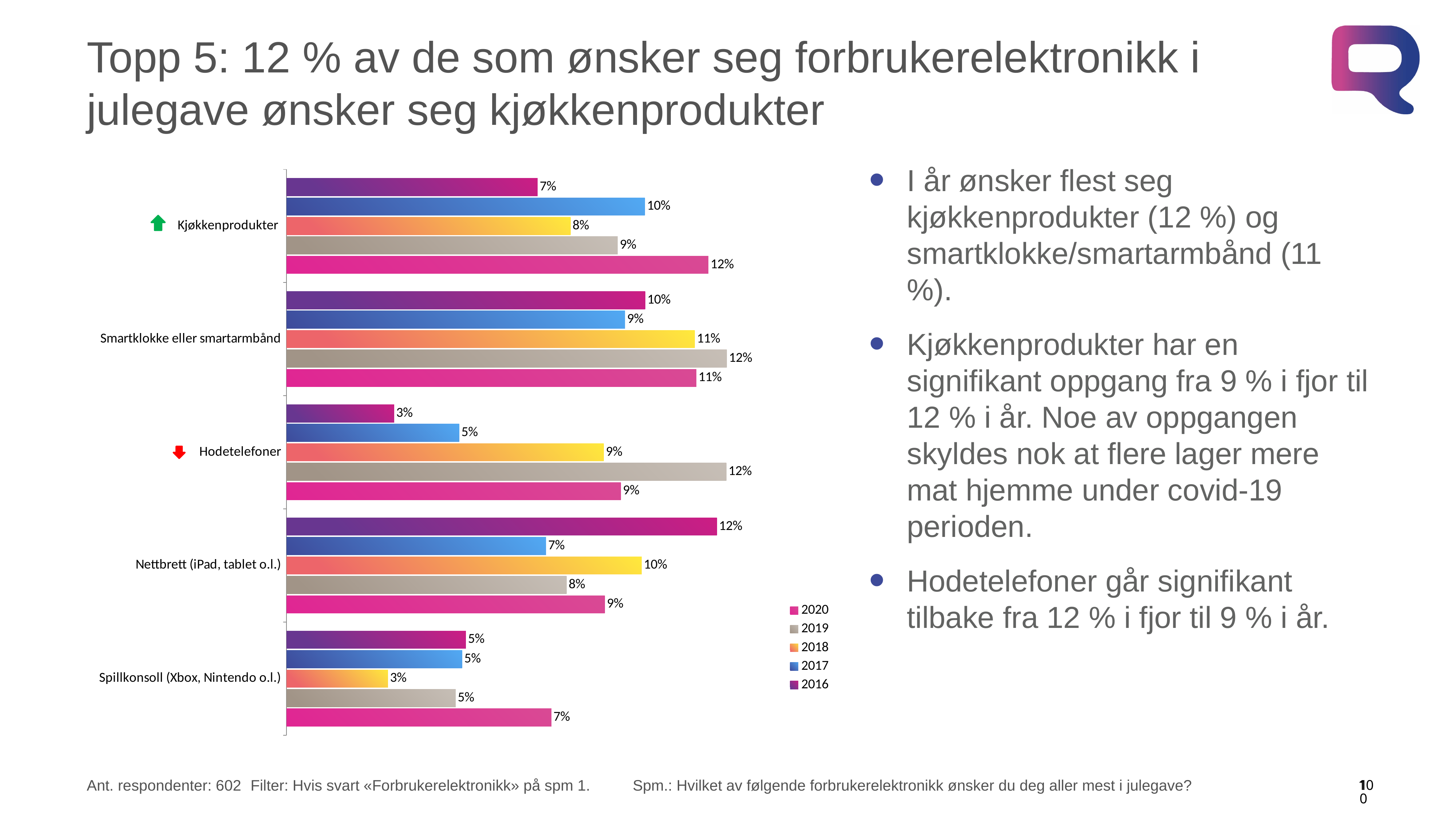
How many series does the legend list? 5 What is the 2018 value for Spillkonsoll (Xbox, Nintendo o.l.)? 3% What is the 2016 value for Nettbrett (iPad, tablet o.l.)? 12% Which category has the highest 2020 value? Kjøkkenprodukter Which series is shown in the legend with the grey colour? 2019 Which category has the lowest 2020 value? Spillkonsoll (Xbox, Nintendo o.l.) What kind of chart is shown on the slide? bar chart How many product categories are shown on the chart? 5 What is the difference between the 2019 and 2020 values for Hodetelefoner? 3% What is the 2019 value for Hodetelefoner? 12% What is the 2020 value for Kjøkkenprodukter? 12% Which is larger for Smartklokke eller smartarmbånd: the 2017 value or the 2019 value? 2019